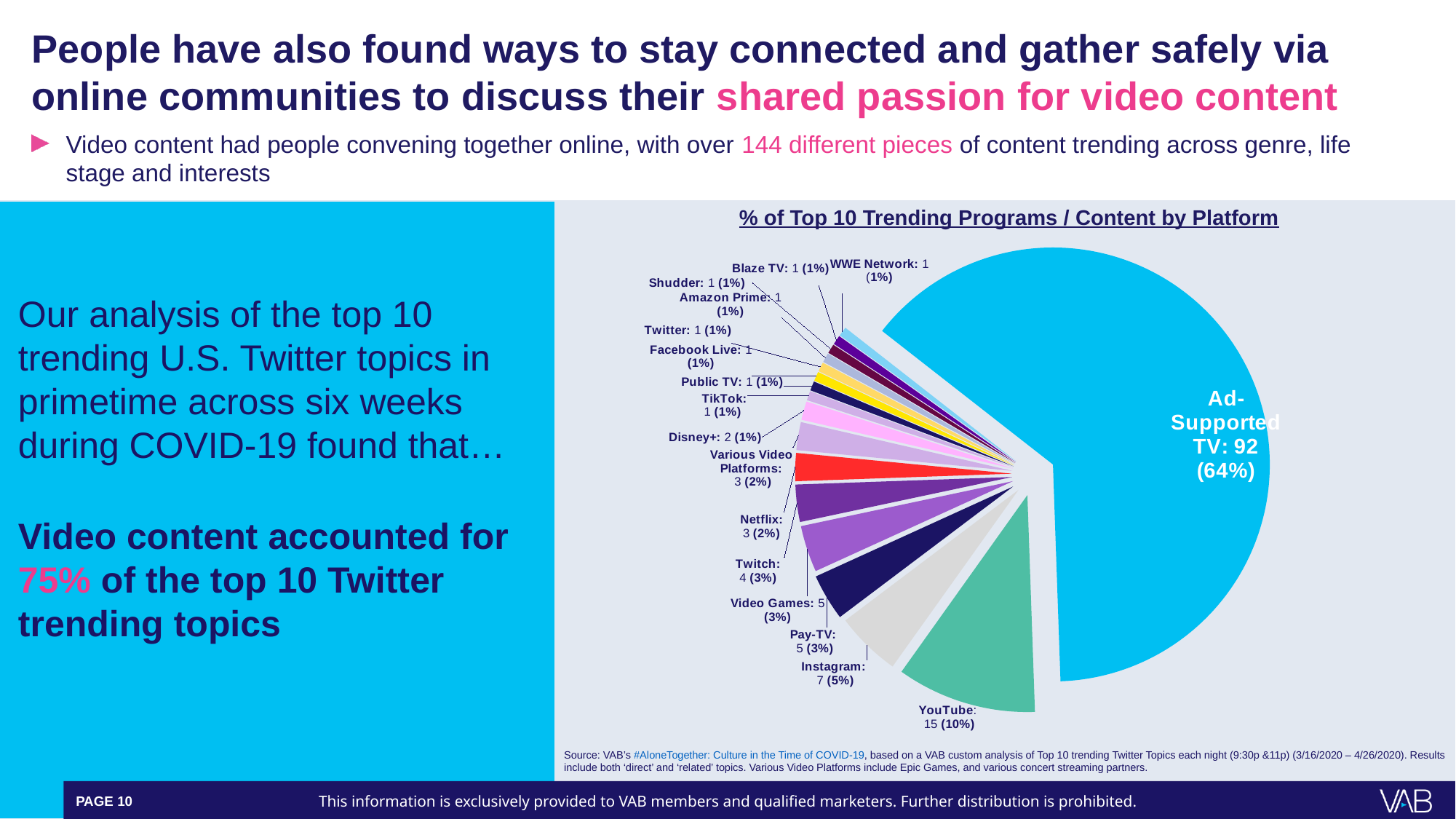
Which platform has the largest slice of the pie? Ad-Supported TV What type of chart is shown on the slide? Pie chart What share of the pie does Ad-Supported TV account for? 64% What is the difference between the counts for Ad-Supported TV and YouTube? 77 Which has a larger count, Instagram or Pay-TV? Instagram What percentage is shown for Instagram? 5% How many platform slices are shown in the pie chart? 17 What is the count shown for Twitch? 4 What is the count shown for Disney+? 2 What is the count shown for YouTube? 15 What is the title of the chart? % of Top 10 Trending Programs / Content by Platform What percentage is shown for Netflix? 2%